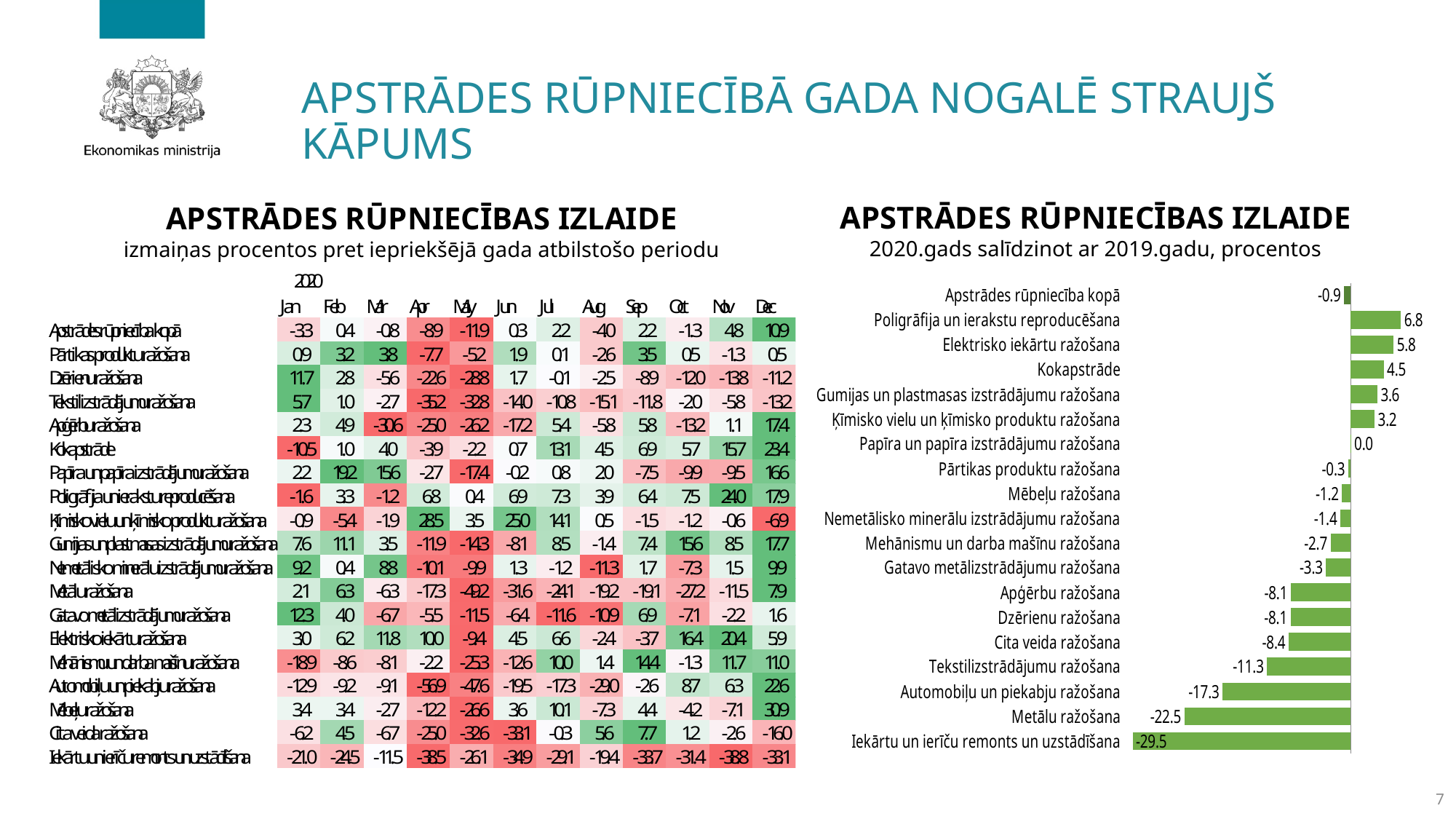
In the right-hand bar chart, which category has the lowest value? Iekārtu un ierīču remonts un uzstādīšana In the right-hand bar chart, what is the value for Apstrādes rūpniecība kopā? -0.9 In the right-hand bar chart, what is the value for Mehānismu un darba mašīnu ražošana? -2.7 In the right-hand bar chart, which category has the highest value? Poligrāfija un ierakstu reproducēšana In the right-hand bar chart, which is larger: the value for Gumijas un plastmasas izstrādājumu ražošana or the value for Ķīmisko vielu un ķīmisko produktu ražošana? Gumijas un plastmasas izstrādājumu ražošana In the right-hand bar chart, what is the value for Metālu ražošana? -22.5 In the chart 'APSTRĀDES RŪPNIECĪBAS IZLAIDE, 2020.gads salīdzinot ar 2019.gadu', what is the value for Kokapstrāde? 4.5 In the right-hand bar chart, what is the value for Papīra un papīra izstrādājumu ražošana? 0.0 What type of chart is shown on the right side of the slide? Bar chart How many categories are shown in the right-hand bar chart? 19 What is the subtitle of the right-hand chart? 2020.gads salīdzinot ar 2019.gadu, procentos In the right-hand bar chart, what is the difference between the values for Automobiļu un piekabju ražošana and Tekstilizstrādājumu ražošana? 6.0